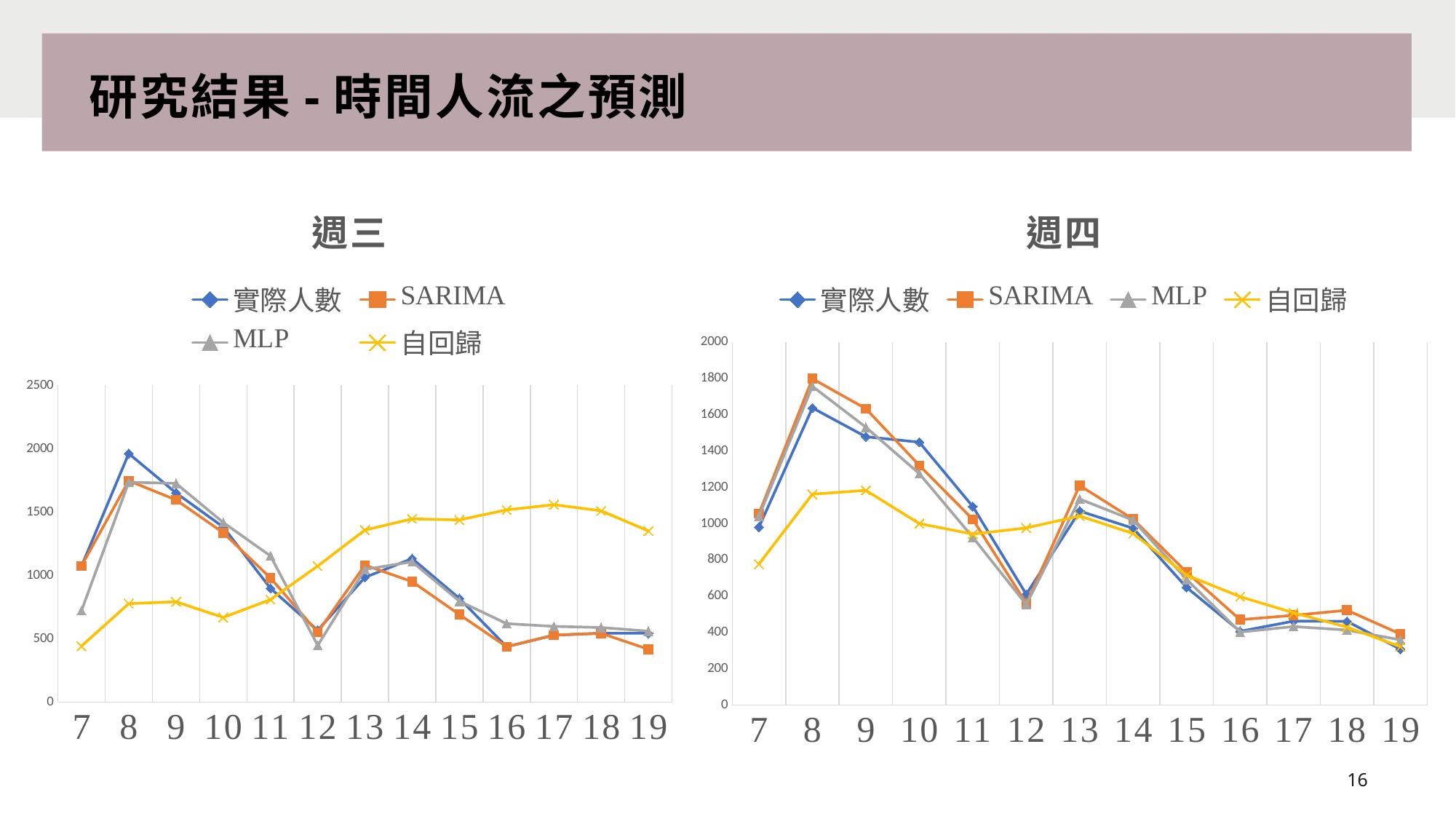
In the 週三 chart, at which hour is 自回歸 at its lowest value? 7 In the 週三 chart, at which hour does 實際人數 reach its highest value? 8 How many series does the legend of the 週四 chart list? 4 In the 週三 chart, at hour 17, which is larger: 自回歸 or SARIMA? 自回歸 What is the title of the chart on the right side of the slide? 週四 In the 週四 chart, does 實際人數 rise or fall from hour 13 to hour 19? fall In the 週三 chart, is the value of 實際人數 at hour 8 greater or less than 1500? greater How many hour points are plotted along the x axis of the 週三 chart? 13 In the 週四 chart, at which hour does SARIMA reach its highest value? 8 What kind of chart is the 週三 chart? line chart In the 週四 chart, is the value of 自回歸 at hour 7 greater or less than 1000? less In the 週三 chart, is the value of MLP at hour 12 greater or less than 500? less